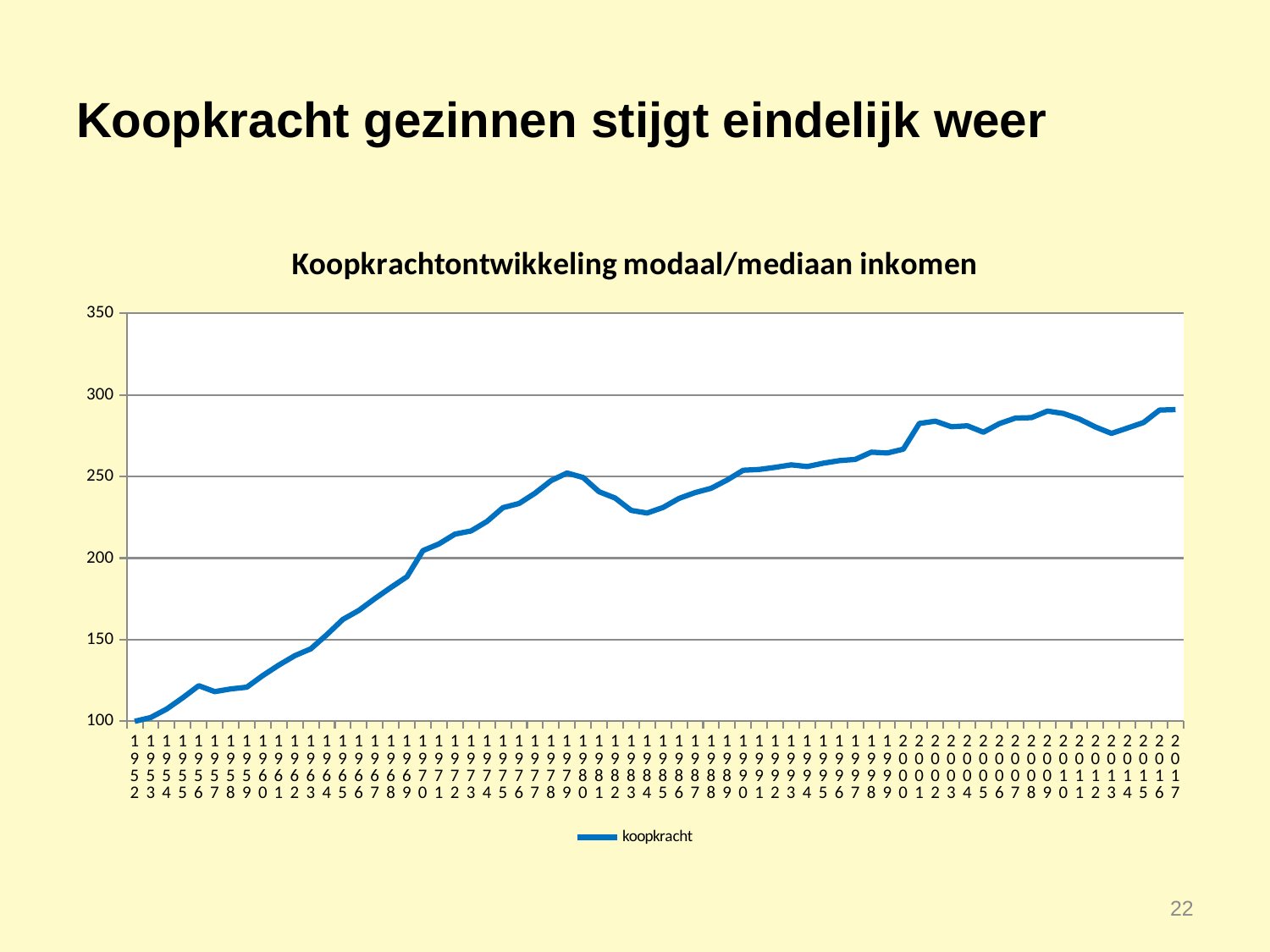
What kind of chart is shown on the slide? line chart Which year has the larger koopkracht value, 1990 or 2000? 2000 How many series does the legend list? 1 Is the koopkracht value for 1980 greater or less than 200? greater Which year has the lowest koopkracht value? 1952 Is the koopkracht value for 2017 greater or less than 300? less Is the koopkracht value for 1965 greater or less than 150? greater Does the koopkracht value generally rise or fall from 1952 to 2017? rise What is the name of the series shown in the legend? koopkracht How many years (data points) are plotted along the x axis? 66 What is the title of the chart? Koopkrachtontwikkeling modaal/mediaan inkomen